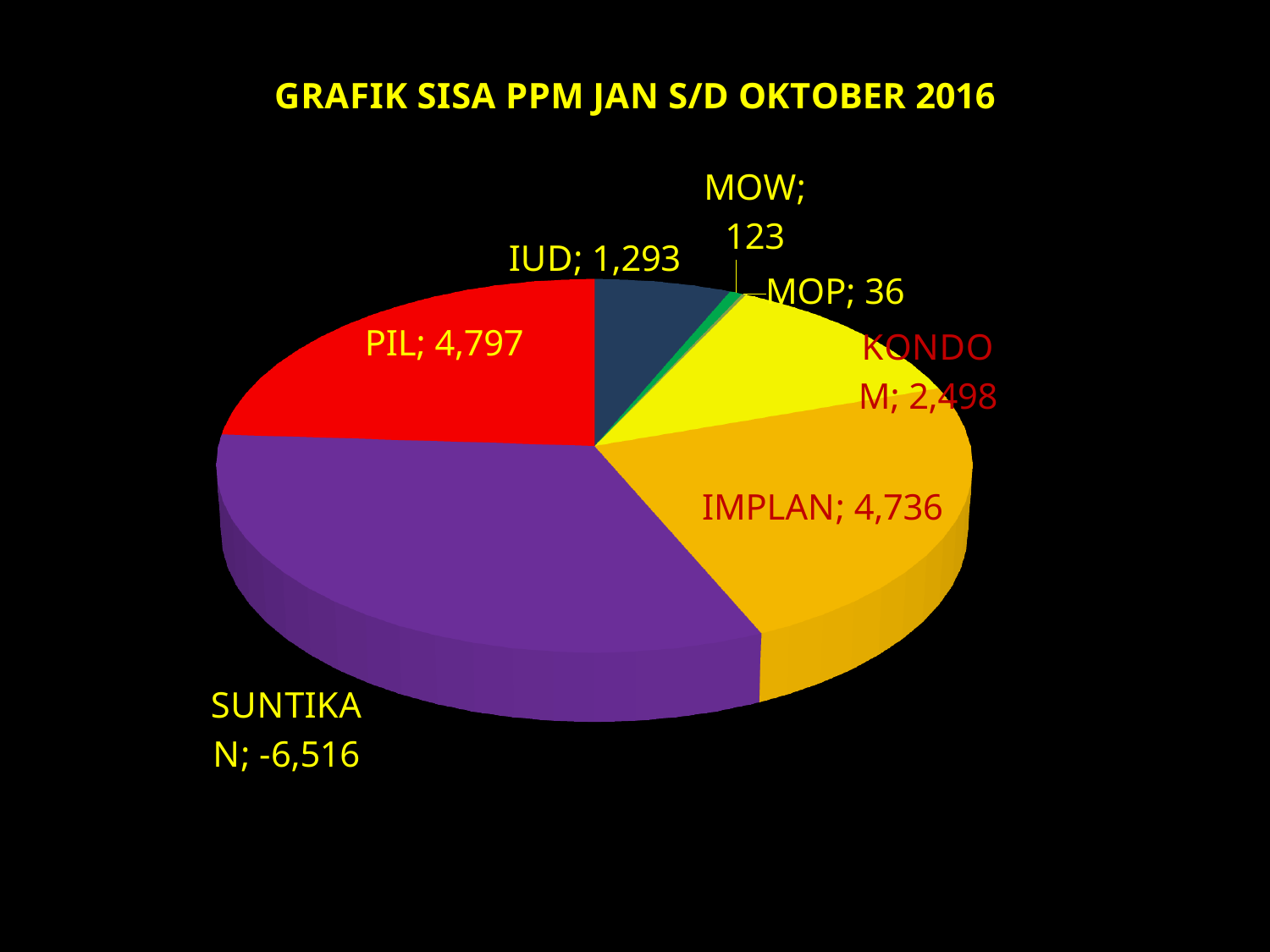
What is the difference between the values for PIL and IMPLAN? 61 Which category has the highest value? PIL How many categories are shown in the pie chart? 7 Which has a larger value, KONDOM or IUD? KONDOM What is the title of the chart? GRAFIK SISA PPM JAN S/D OKTOBER 2016 What kind of chart is shown on the slide? pie chart Which category has the lowest value? SUNTIKAN What is the value for PIL? 4,797 What is the value for IMPLAN? 4,736 What is the value for MOP? 36 What is the value for SUNTIKAN? -6,516 What is the value for KONDOM? 2,498